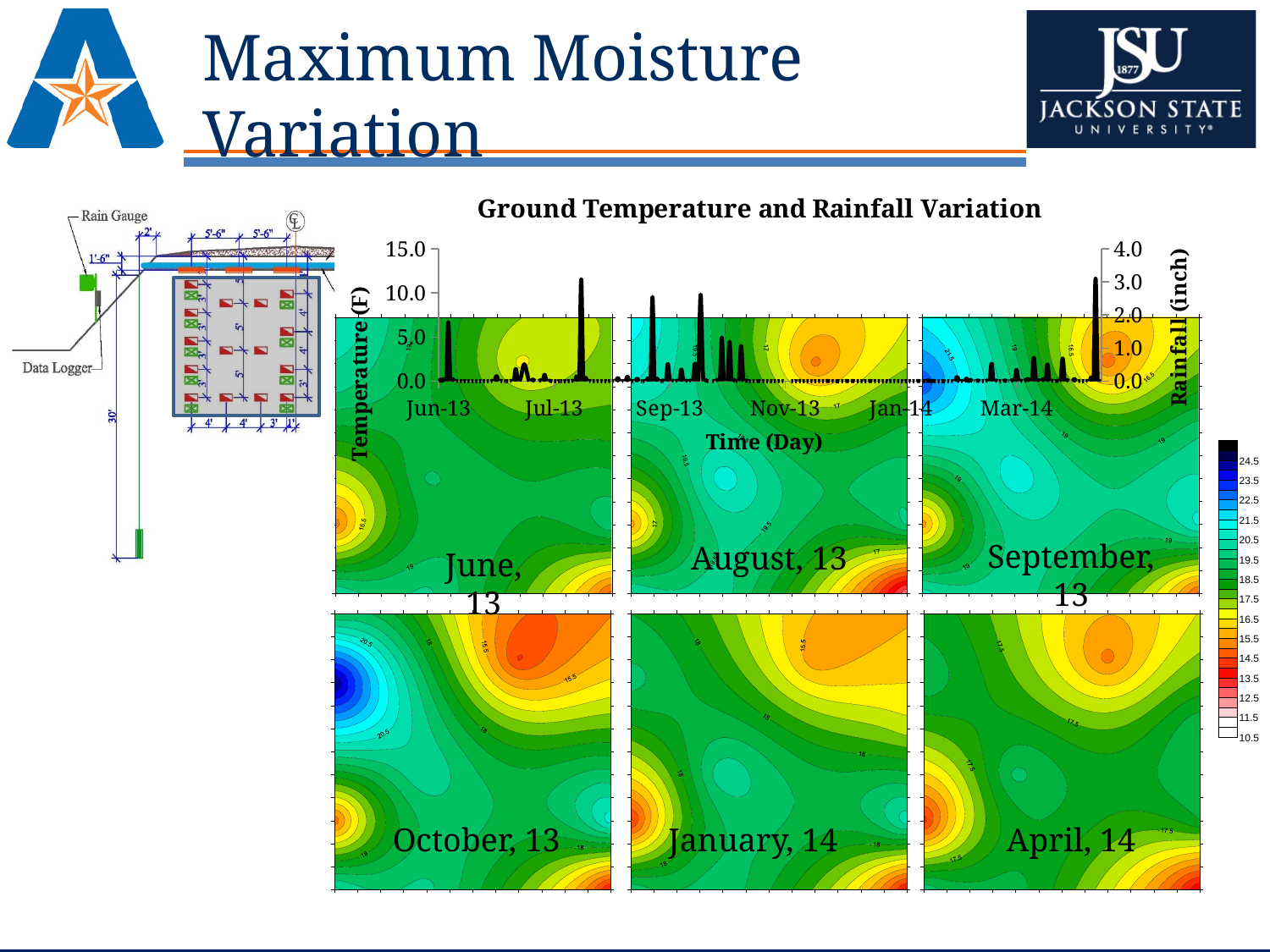
What kind of chart is the Ground Temperature and Rainfall Variation chart? line chart What is the last month label on the x axis of the Ground Temperature and Rainfall Variation chart? Mar-14 How many month labels are shown along the x axis of the Ground Temperature and Rainfall Variation chart? 6 What is the label of the x axis of the Ground Temperature and Rainfall Variation chart? Time (Day) What is the first month label on the x axis of the Ground Temperature and Rainfall Variation chart? Jun-13 What is the title of the chart on the slide? Ground Temperature and Rainfall Variation How many contour panels (monthly maps) are shown on the slide? 6